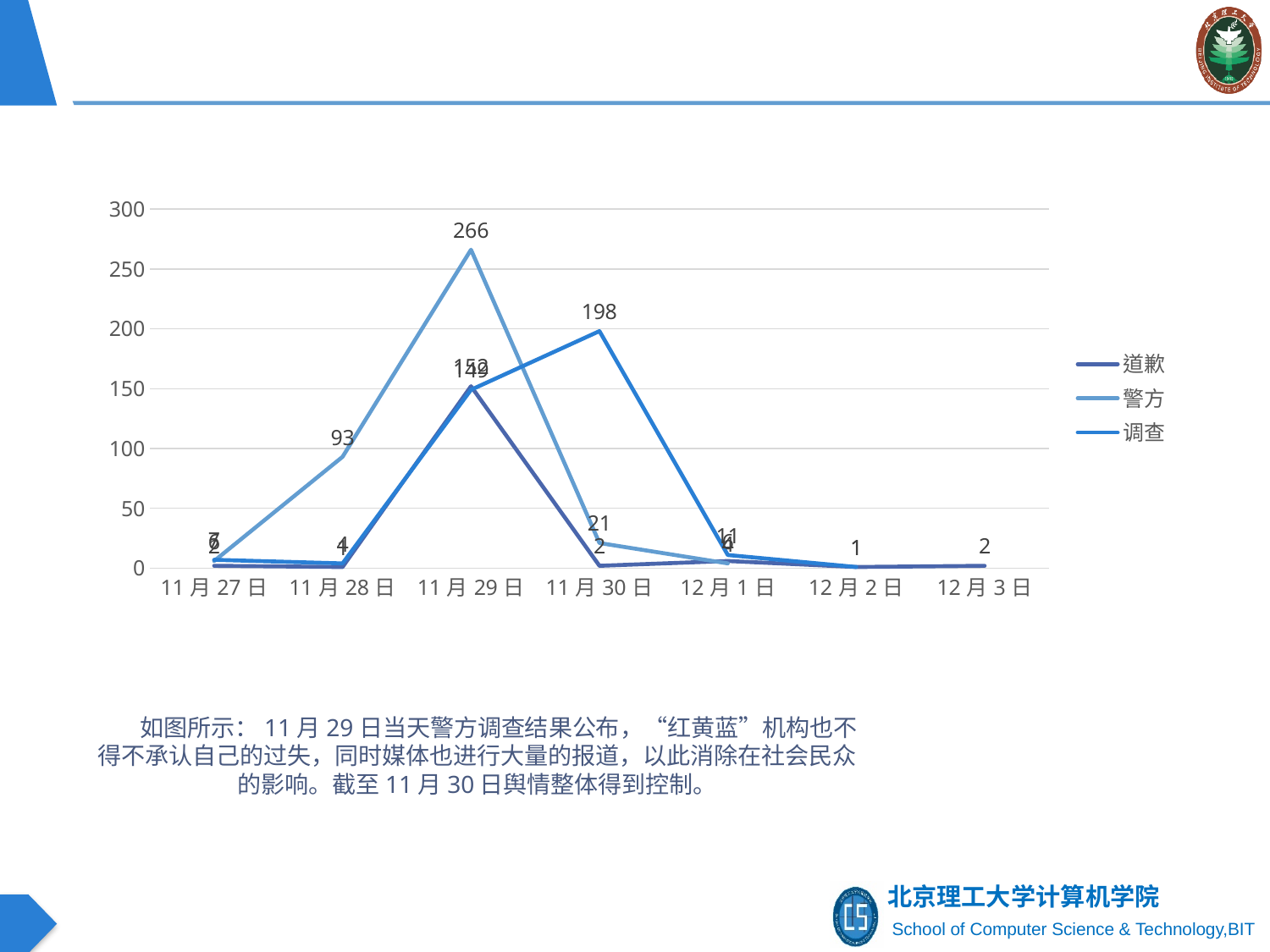
How many series does the legend list? 3 On which date does the 警方 series reach its highest value? 11月29日 What kind of chart is shown on the slide? line chart How many dates are shown along the x axis? 7 What is the value of 调查 on 11月30日? 198 What is the value of 警方 on 11月29日? 266 What is the value of 警方 on 11月28日? 93 Is the value for 调查 on 11月29日 greater or less than 100? greater Which is larger: the peak of 警方 on 11月29日 or the peak of 调查 on 11月30日? 警方 on 11月29日 On which date does the 调查 series reach its highest value? 11月30日 What is the difference between the 警方 values on 11月29日 and 11月28日? 173